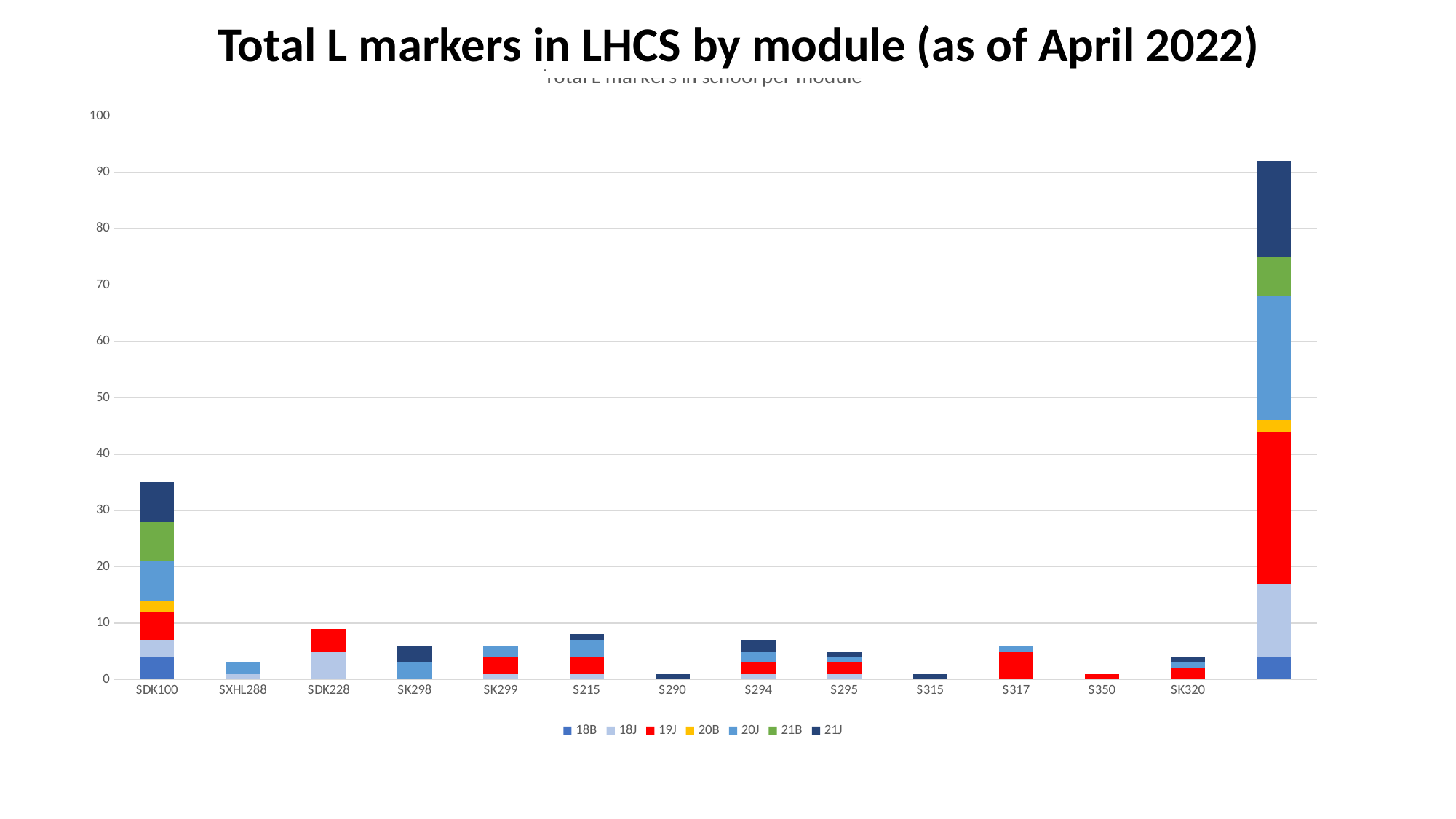
Is the total value for SDK228 greater or less than 10? less Is the total value for SXHL288 greater or less than 10? less What kind of chart is shown on the slide? Stacked bar chart How many series does the legend list? 7 Which has a larger total, SDK228 or SK298? SDK228 What is the title of the slide? Total L markers in LHCS by module (as of April 2022) Which colour represents the 19J series in the legend? Red Is the total value for SDK100 greater or less than 40? less Which has a larger total, SDK100 or S215? SDK100 Which has a larger total, SDK100 or SDK228? SDK100